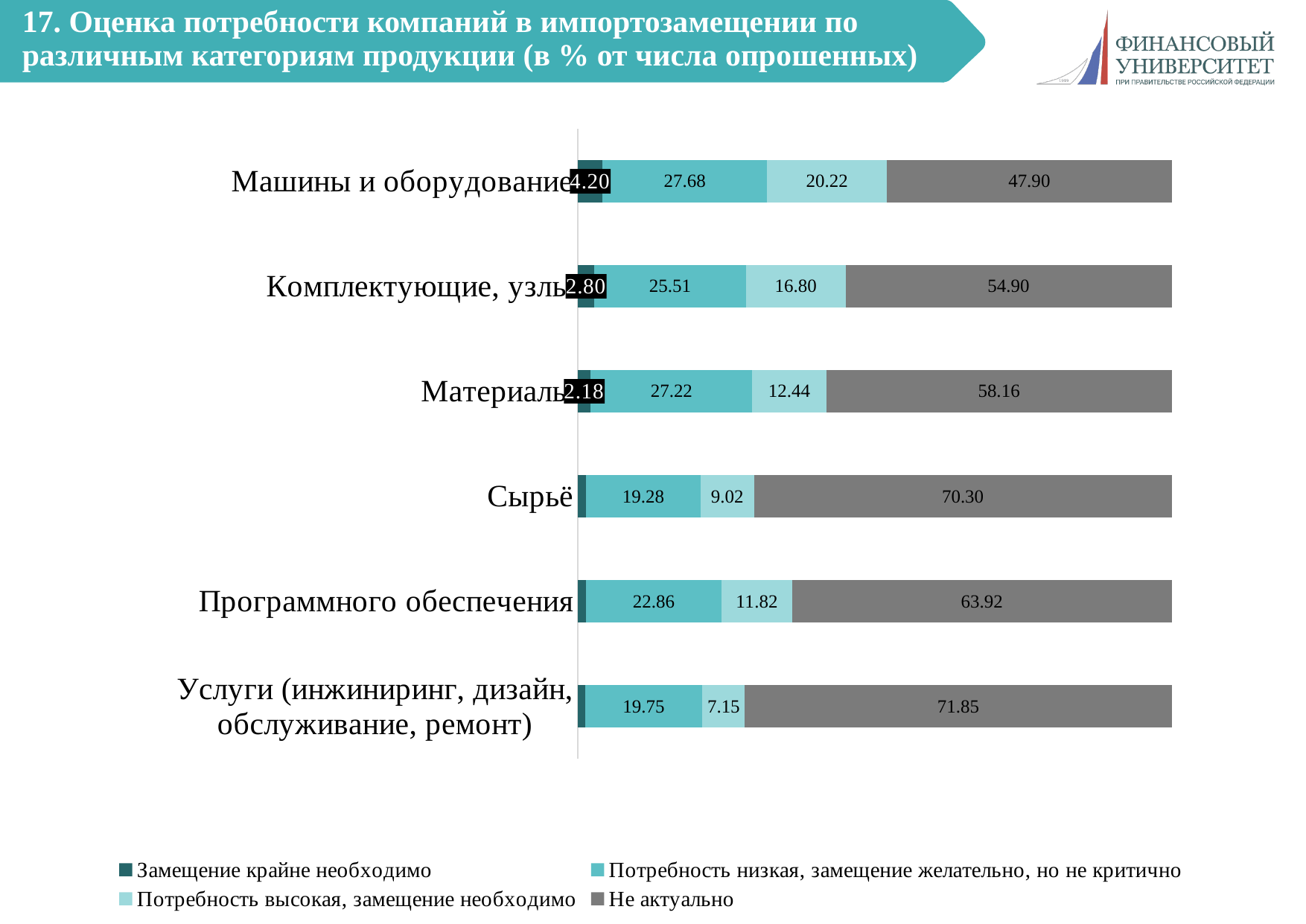
Which category has the highest value for "Потребность высокая, замещение необходимо"? Машины и оборудование What is the value of "Замещение крайне необходимо" for "Машины и оборудование"? 4.20 What is the value of "Потребность высокая, замещение необходимо" for "Комплектующие, узлы"? 16.80 What kind of chart is shown on the slide? Stacked bar chart What is the value of "Потребность низкая, замещение желательно, но не критично" for "Услуги (инжиниринг, дизайн, обслуживание, ремонт)"? 19.75 Which category has the lowest value for "Не актуально"? Машины и оборудование Which category has the highest value for "Не актуально"? Услуги (инжиниринг, дизайн, обслуживание, ремонт) How many product categories are shown in the chart? 6 How many series does the legend list? 4 What is the value of "Не актуально" for "Сырьё"? 70.30 Which has a larger value for "Потребность низкая, замещение желательно, но не критично": "Комплектующие, узлы" or "Программного обеспечения"? Комплектующие, узлы What is the difference between the "Не актуально" values for "Услуги (инжиниринг, дизайн, обслуживание, ремонт)" and "Машины и оборудование"? 23.95